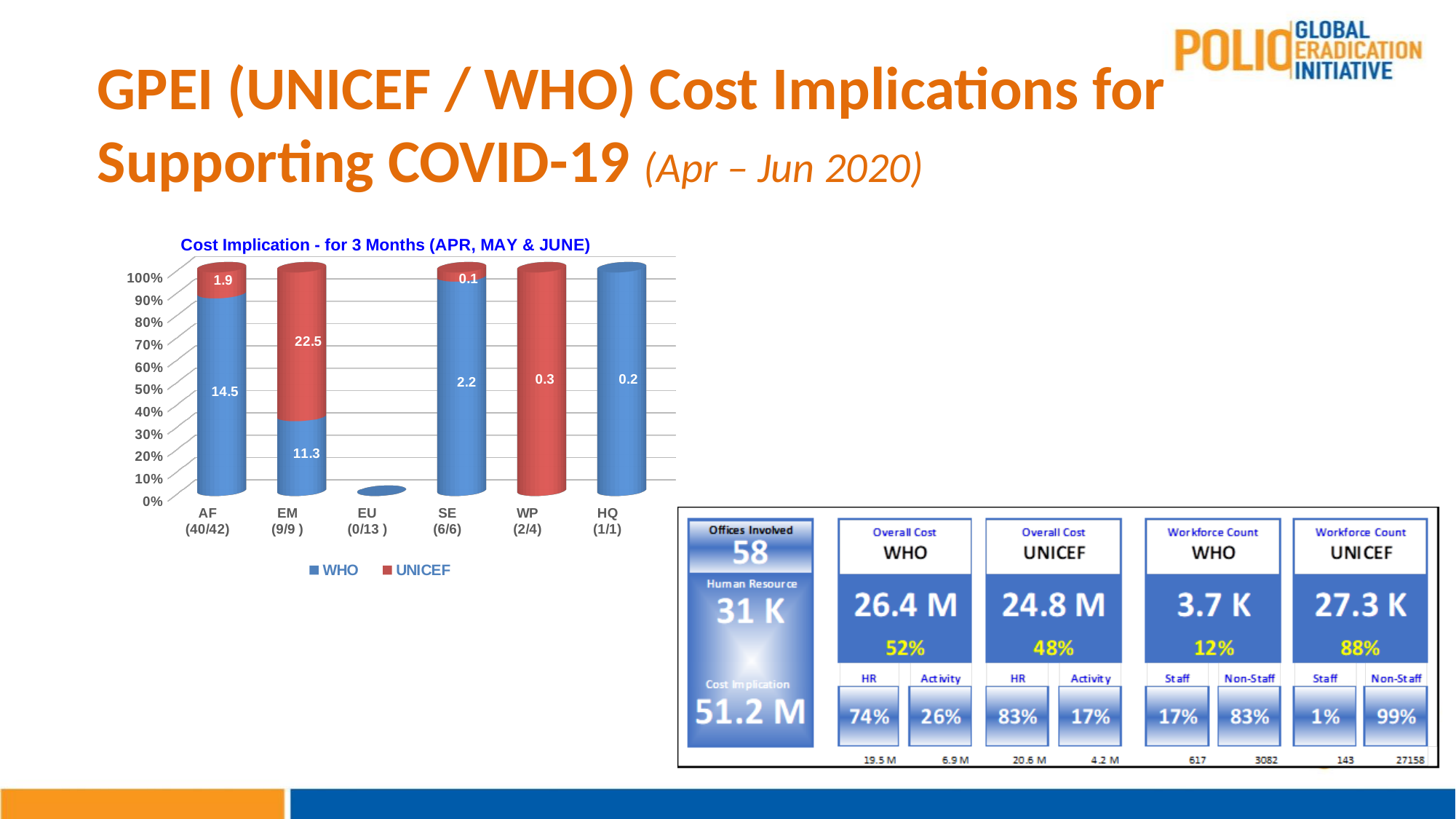
What is the UNICEF value for EM in the Cost Implication chart? 22.5 What is the WHO value for HQ in the Cost Implication chart? 0.2 What is the total of the WHO and UNICEF values for AF in the Cost Implication chart? 16.4 What is the WHO value for AF in the Cost Implication chart? 14.5 What is the WHO value for EM in the Cost Implication chart? 11.3 What kind of chart is the Cost Implication chart? Stacked bar chart Which is larger in the Cost Implication chart: the WHO value for AF or the WHO value for EM? AF How many categories are shown on the x axis of the Cost Implication chart? 6 How many series does the legend of the Cost Implication chart list? 2 What is the UNICEF value for AF in the Cost Implication chart? 1.9 In the Cost Implication chart, how much larger is the UNICEF value than the WHO value for EM? 11.2 Which category has the highest UNICEF value in the Cost Implication chart? EM